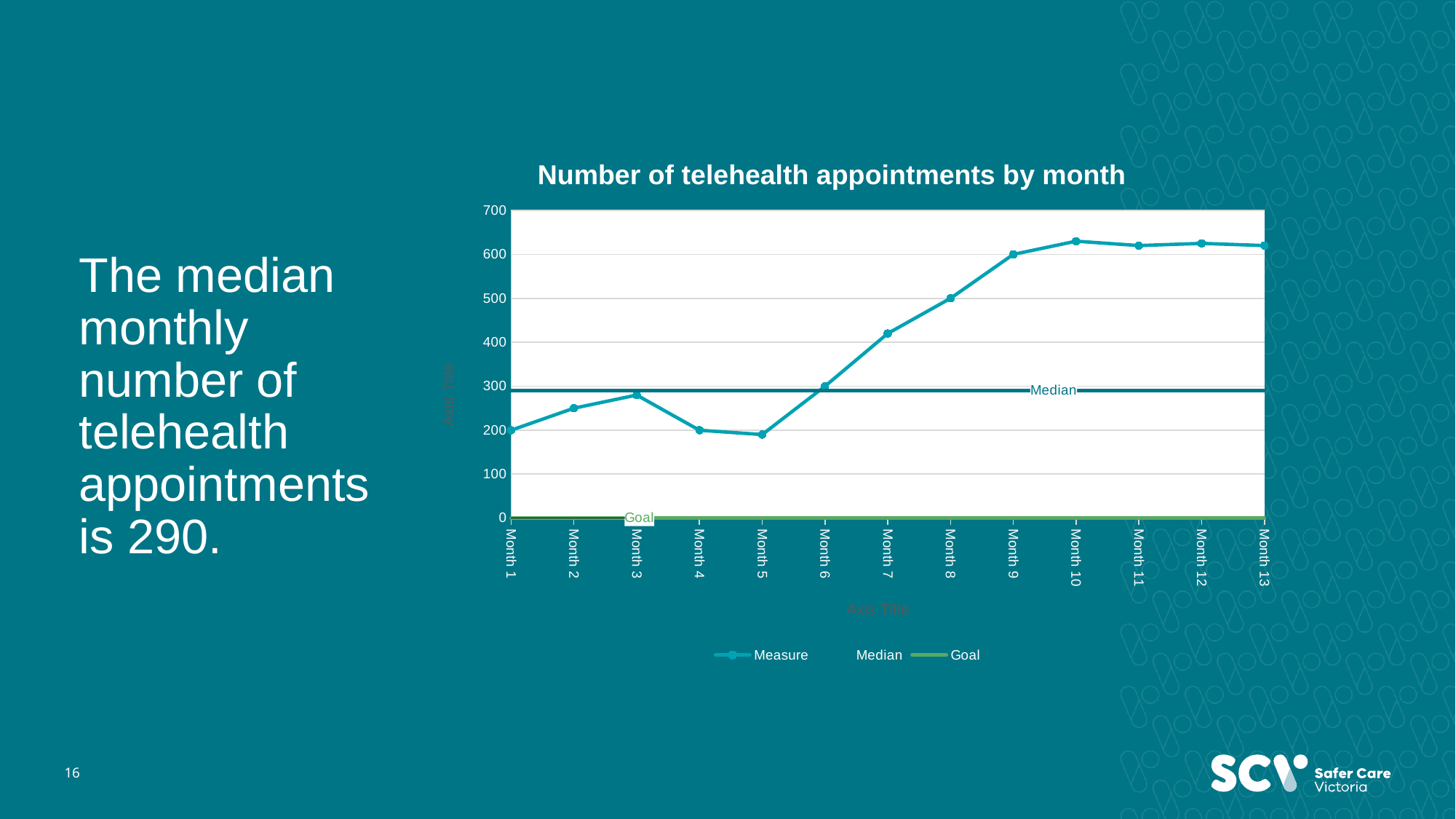
Is the Measure value for Month 7 greater or less than 400? greater Which has a higher Measure value, Month 3 or Month 9? Month 9 What is the Measure value for Month 6? 300 What is the value of the Median line in the chart? 290 What kind of chart is shown on the slide? line chart What is the Measure value for Month 9? 600 Is the Measure value for Month 2 greater or less than 300? less How many months are plotted on the x axis of the chart? 13 How many series does the chart legend list? 3 What is the title of the chart? Number of telehealth appointments by month Does the Measure series generally rise or fall from Month 5 to Month 10? rise Is the Measure value for Month 10 greater or less than 600? greater